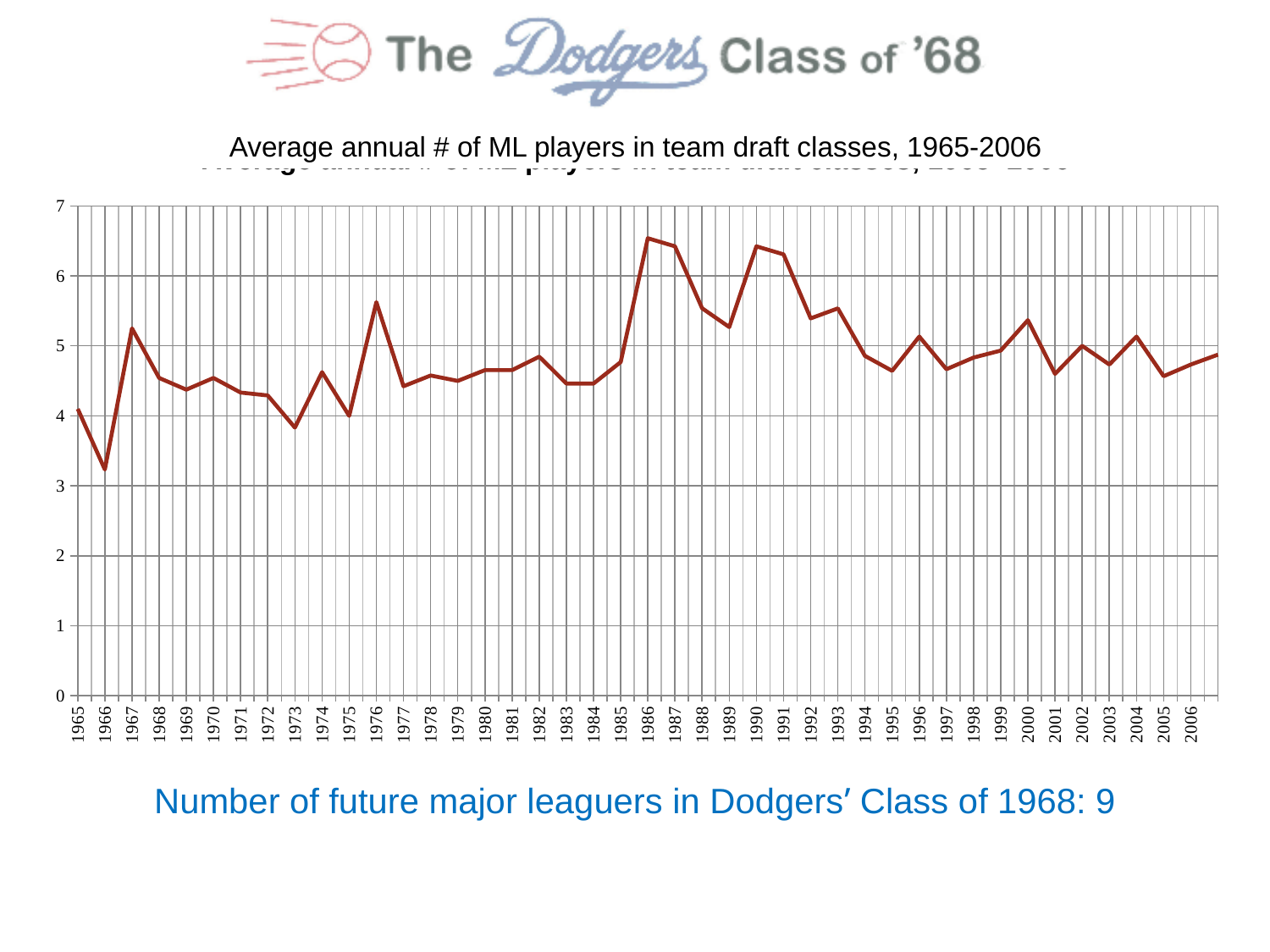
What is the title of the chart? Average annual # of ML players in team draft classes, 1965-2006 What kind of chart is shown on the slide? line chart Is the value for 1966 greater or less than 4? less Do the values rise or fall from 1986 to 1989? fall Is the value for 1976 greater or less than 5? greater Which year has the lowest value on the chart? 1966 Which is larger, the value for 1967 or the value for 1968? 1967 Is the value for 1973 greater or less than 4? less How many years are plotted along the x axis of the chart? 42 Which is larger, the value for 1976 or the value for 1977? 1976